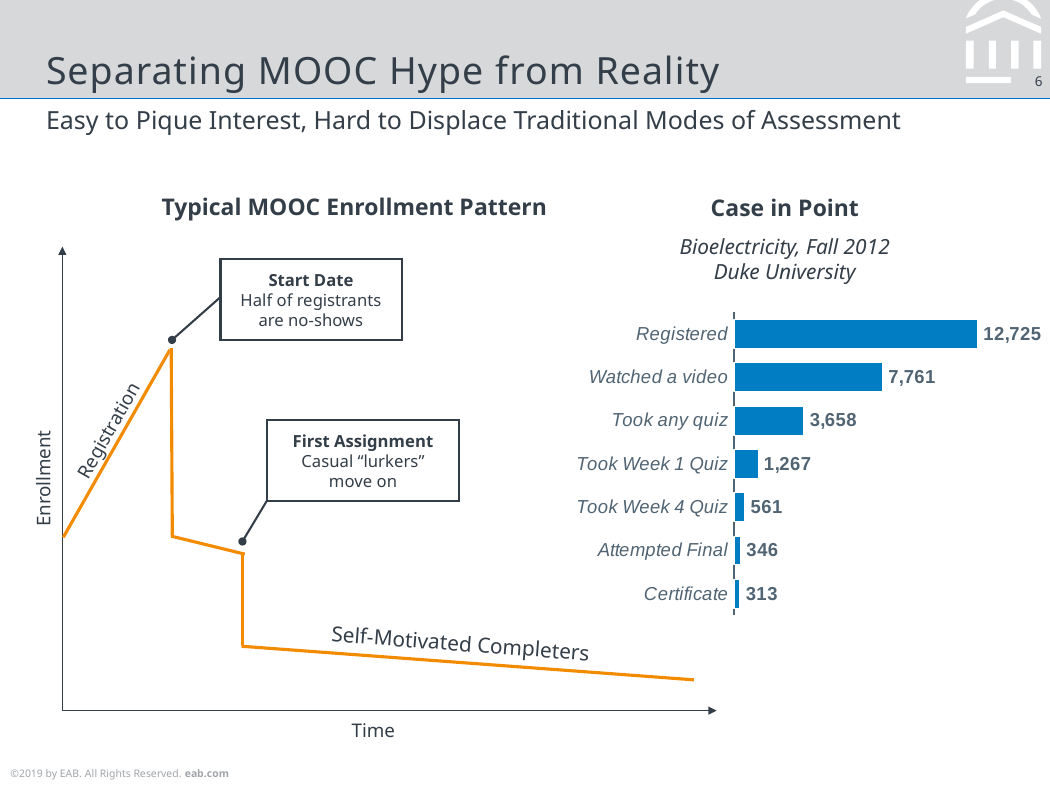
In the Case in Point chart, what is the difference between Registered and Watched a video? 4,964 How many categories are shown in the Case in Point chart? 7 In the Case in Point chart, how many students registered? 12,725 In the Case in Point chart, which category has the highest value? Registered In the Case in Point chart, how many students earned a Certificate? 313 In the Case in Point chart, what is the value for Watched a video? 7,761 In the Case in Point chart, what is the value for Took Week 4 Quiz? 561 In the Case in Point chart, which is larger: Attempted Final or Certificate? Attempted Final In the Case in Point chart, which category has the lowest value? Certificate In the Case in Point chart, what is the difference between Took any quiz and Took Week 1 Quiz? 2,391 In the Typical MOOC Enrollment Pattern chart, what is the label on the x axis? Time What kind of chart is the Case in Point chart? Bar chart